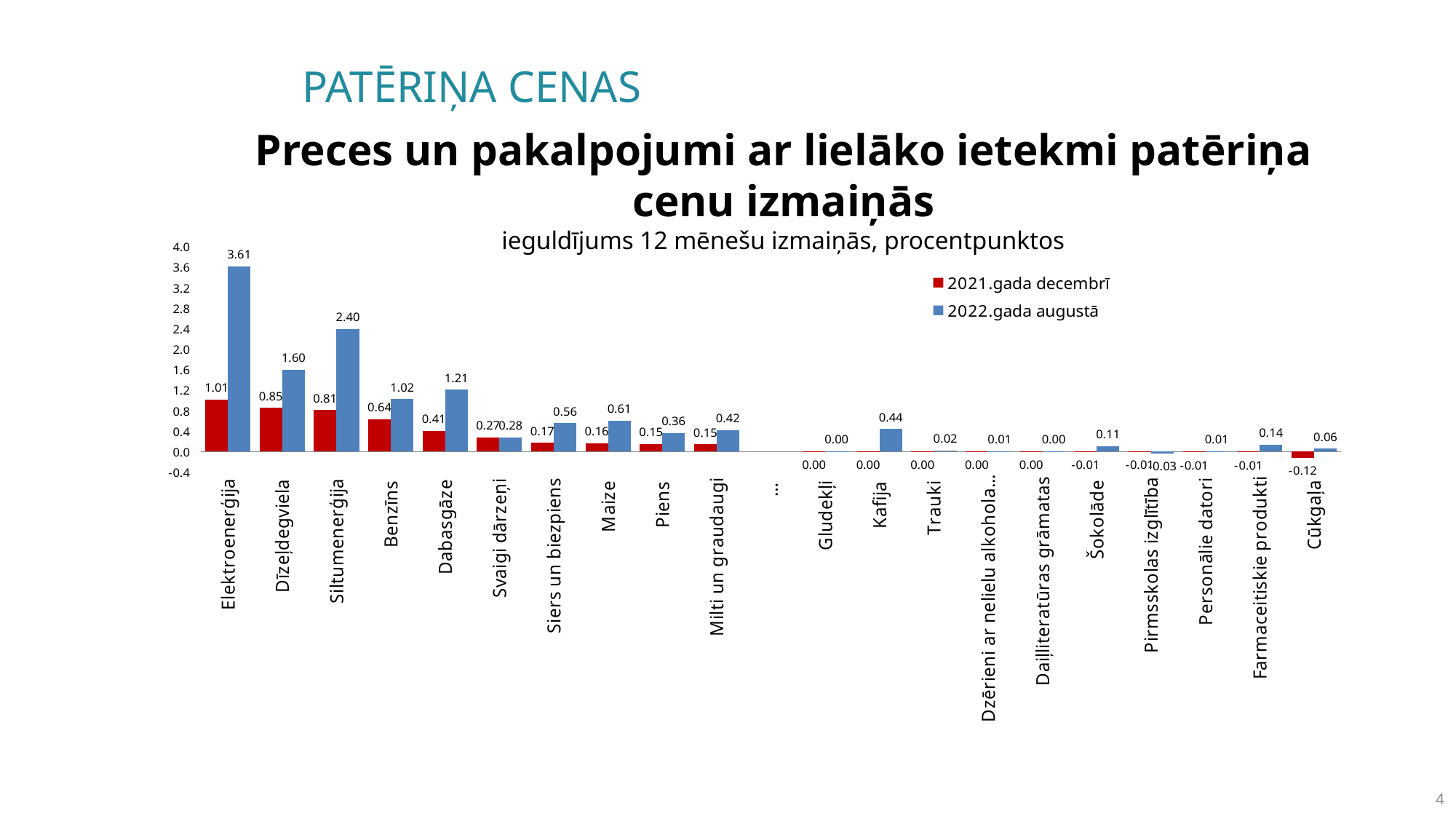
In the 2022.gada augustā series, which is larger: Dabasgāze or Benzīns? Dabasgāze What is the value for Siltumenerģija in the 2021.gada decembrī series? 0.81 What kind of chart is shown on the slide? bar chart What is the difference between the 2022.gada augustā and 2021.gada decembrī values for Elektroenerģija? 2.60 Which category has the lowest value in the 2021.gada decembrī series? Cūkgaļa Is the 2022.gada augustā value for Siltumenerģija greater or less than 2.0? greater How many series does the legend list? 2 What is the difference between the 2022.gada augustā and 2021.gada decembrī values for Dīzeļdegviela? 0.75 What is the value for Elektroenerģija in the 2022.gada augustā series? 3.61 Which category has the highest value in the 2022.gada augustā series? Elektroenerģija What is the value for Cūkgaļa in the 2021.gada decembrī series? -0.12 What is the value for Kafija in the 2022.gada augustā series? 0.44